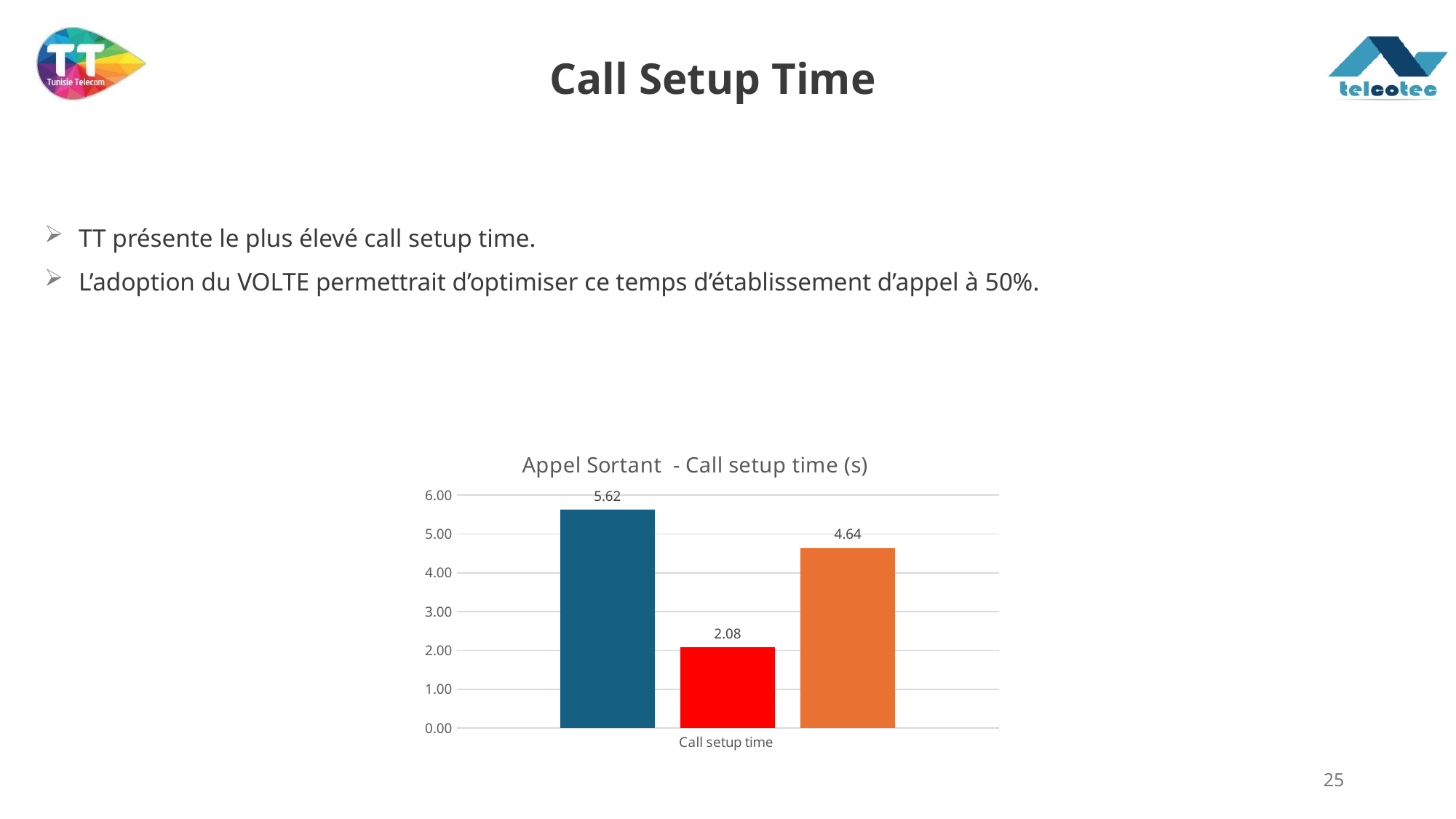
What is the difference between the dark blue bar and the orange bar? 0.98 Which bar has the lowest value in the chart? the red bar (2.08) What is the title of the chart? Appel Sortant - Call setup time (s) What is the value of the orange bar in the chart? 4.64 Which bar has the highest value in the chart? the dark blue bar (5.62) What is the value of the red bar in the chart? 2.08 How many bars are plotted in the chart? 3 What is the difference between the orange bar and the red bar? 2.56 What is the category label shown on the x axis of the chart? Call setup time Which is larger, the red bar or the orange bar? the orange bar What type of chart is shown on the slide? bar chart What is the value of the dark blue bar in the chart? 5.62